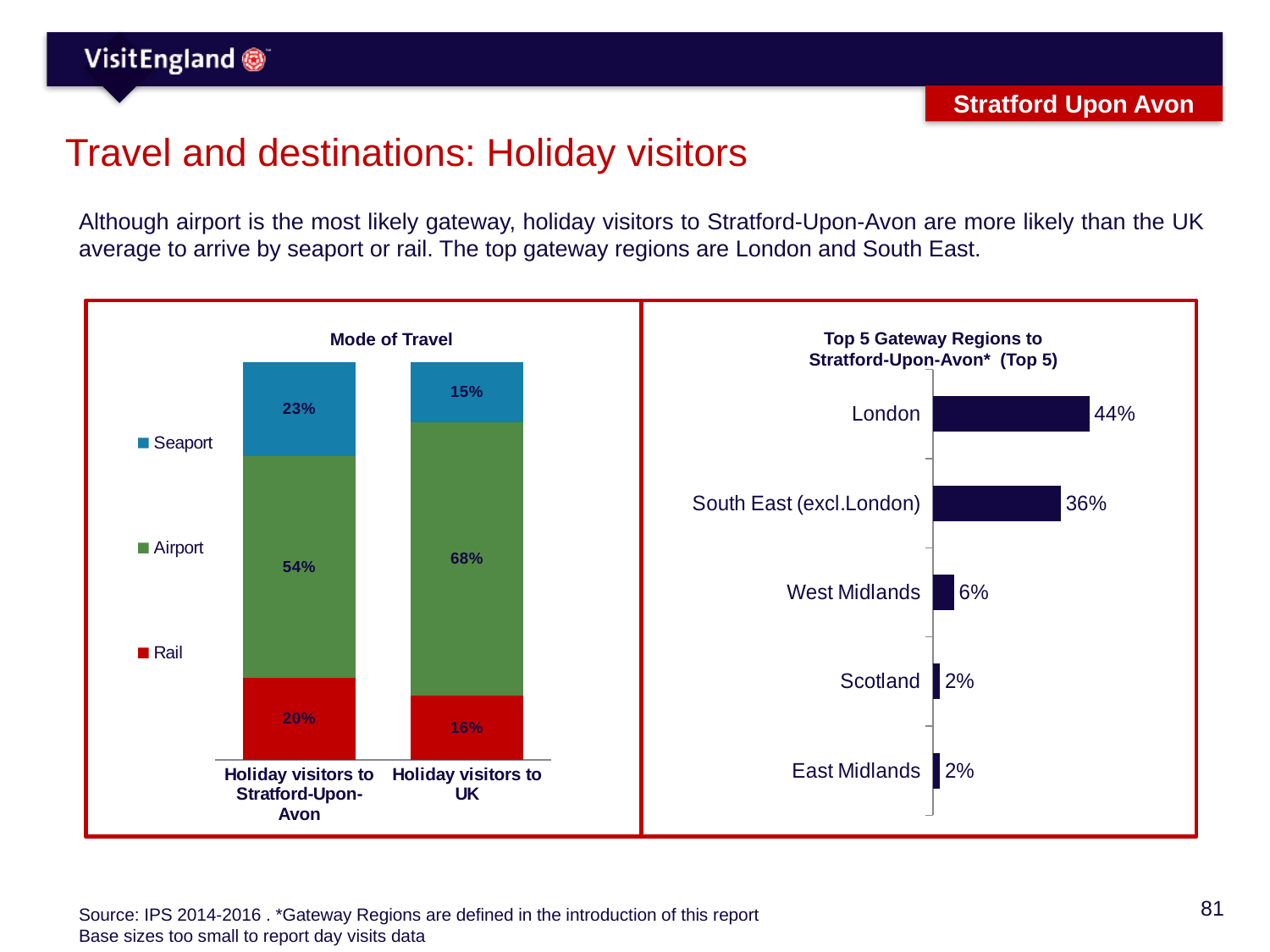
In the Mode of Travel chart, what percentage of holiday visitors to Stratford-Upon-Avon arrive by Seaport? 23% In the Top 5 Gateway Regions chart, which region has the highest value? London In the Mode of Travel chart, what percentage of holiday visitors to the UK arrive by Airport? 68% What kind of chart is the Top 5 Gateway Regions chart? Bar chart In the Mode of Travel chart, what is the Rail share for holiday visitors to Stratford-Upon-Avon? 20% In the Mode of Travel chart, what is the difference between the Airport share for holiday visitors to the UK and for holiday visitors to Stratford-Upon-Avon? 14% In the Top 5 Gateway Regions chart, what is the value for South East (excl.London)? 36% In the Mode of Travel chart, how many series does the legend list? 3 In the Top 5 Gateway Regions chart, how many regions are shown? 5 In the Mode of Travel chart, which is larger: the Seaport share for holiday visitors to Stratford-Upon-Avon or for holiday visitors to the UK? Holiday visitors to Stratford-Upon-Avon In the Mode of Travel chart, what is the total of the stacked bar for holiday visitors to the UK? 99% In the Top 5 Gateway Regions chart, what is the difference between London and West Midlands? 38%